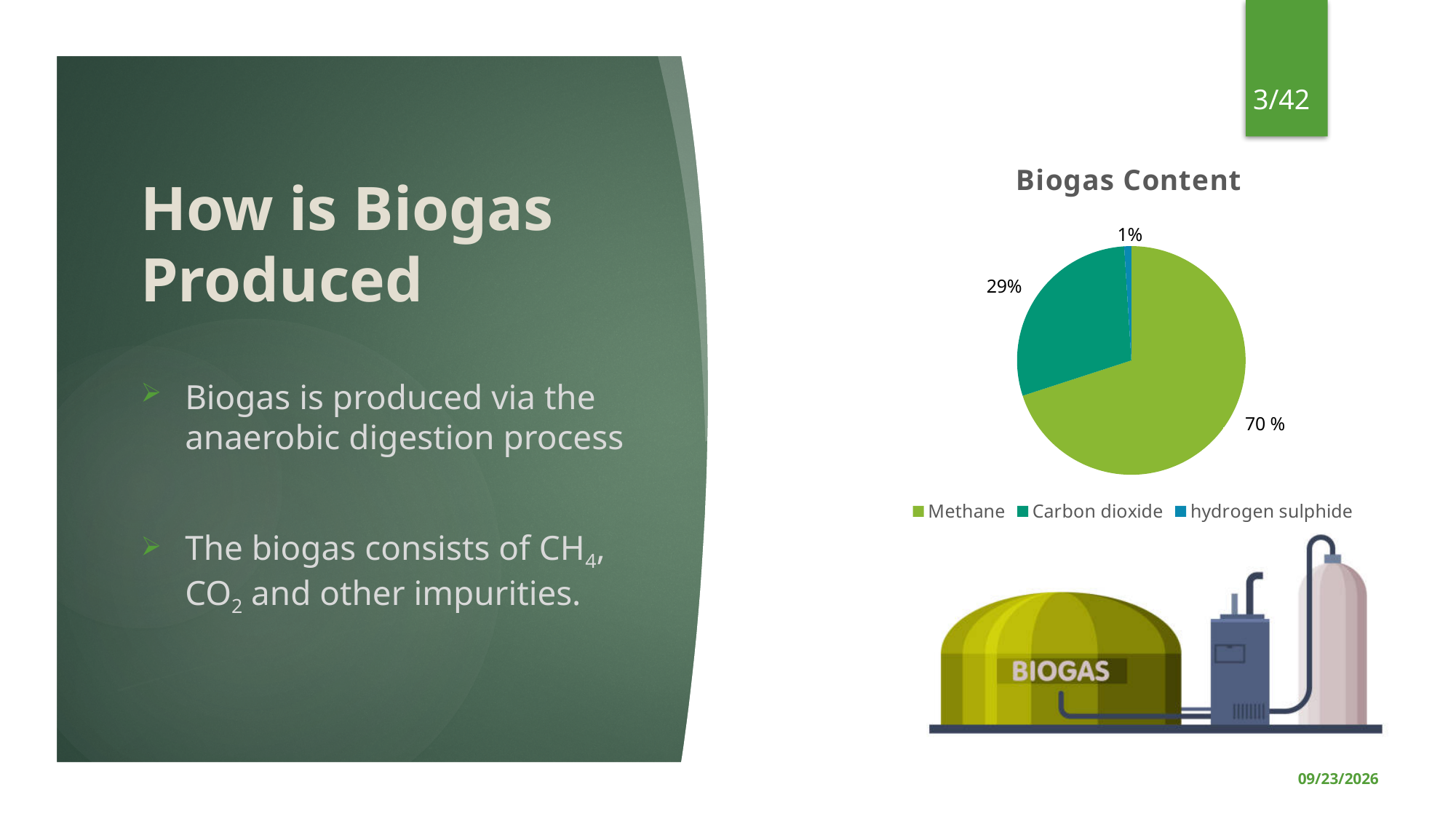
What kind of chart is shown on the slide? pie chart What is the title of the chart? Biogas Content Which legend entry is shown in the darker teal colour? Carbon dioxide What is the difference in percentage points between the Methane share and the Carbon dioxide share? 41 What share of the pie does hydrogen sulphide have? 1% Which is larger, the share for Carbon dioxide or the share for hydrogen sulphide? Carbon dioxide What share of the pie does Methane have? 70 % How many entries does the legend list? 3 Which component has the smallest share of the pie? hydrogen sulphide What share of the pie does Carbon dioxide have? 29% How many slices does the pie chart have? 3 Which component has the largest share of the pie? Methane